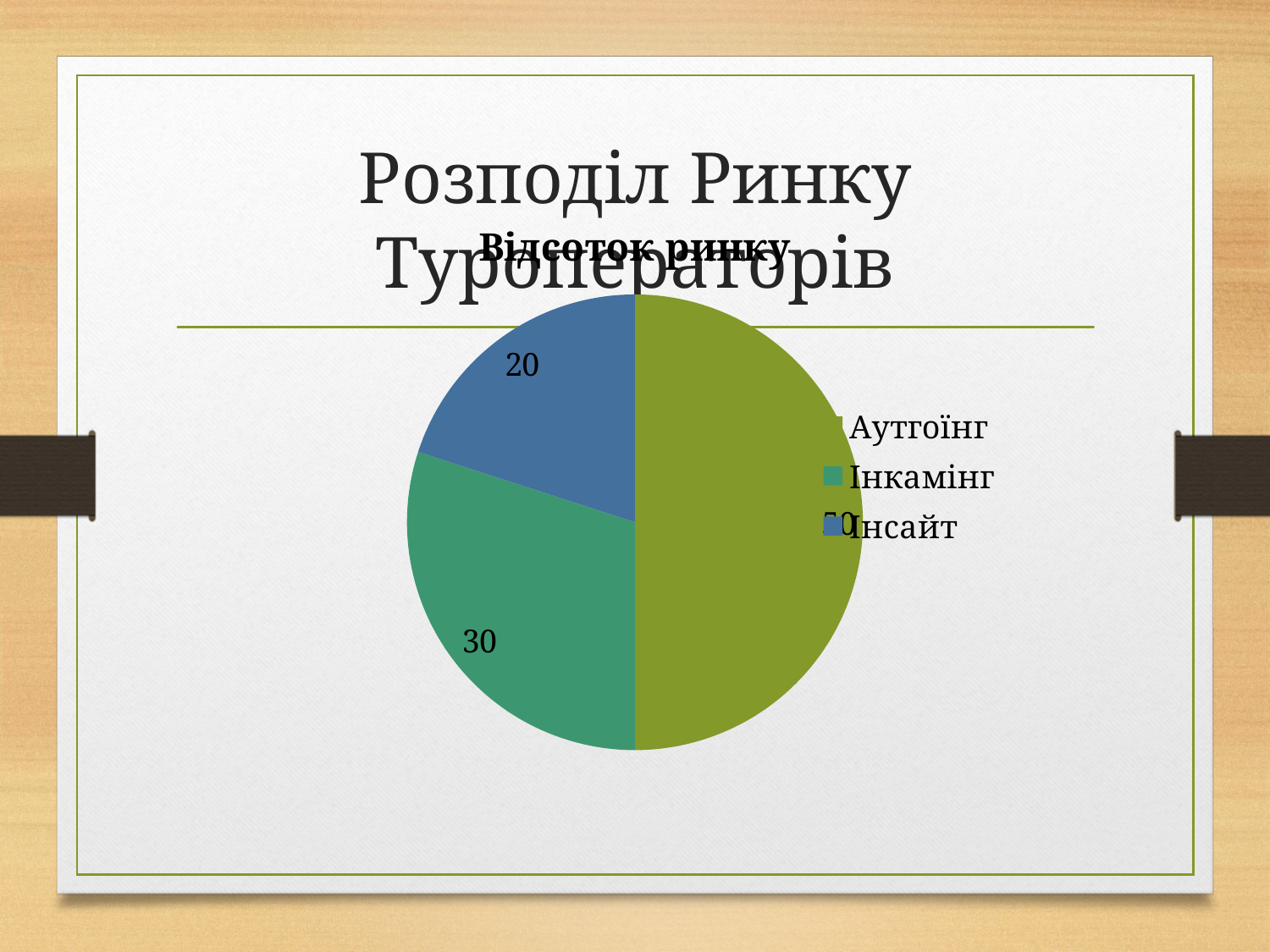
Which is larger, the slice for Аутгоїнг or the slice for Інкамінг? Аутгоїнг How many slices does the pie chart have? 3 Which category has the largest slice of the pie? Аутгоїнг What is the value shown for Інкамінг? 30 What kind of chart is shown on the slide? pie chart Which category has the smallest slice of the pie? Інсайт How many entries does the legend list? 3 Which legend entry is shown in blue? Інсайт What is the value shown for Інсайт? 20 What is the title of the chart? Відсоток ринку What is the difference between the values for Інкамінг and Інсайт? 10 Which is larger, the value for Інкамінг or the value for Інсайт? Інкамінг